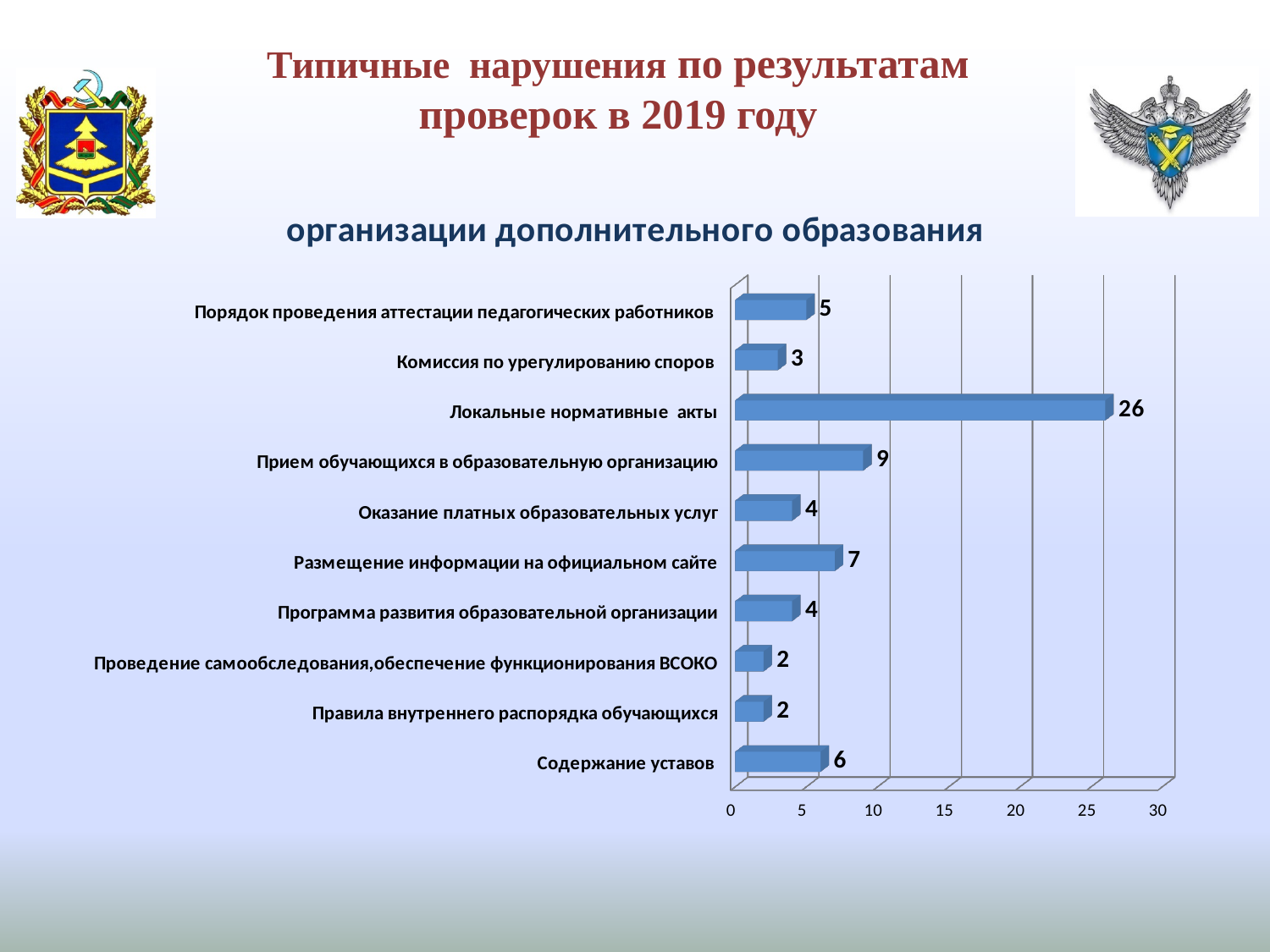
What is the value for Локальные нормативные акты? 26 How many categories are shown in the chart? 10 What is the value for Комиссия по урегулированию споров? 3 Which is larger: the value for Размещение информации на официальном сайте or the value for Порядок проведения аттестации педагогических работников? Размещение информации на официальном сайте Which category has the highest value? Локальные нормативные акты What is the value for Прием обучающихся в образовательную организацию? 9 Is the value for Локальные нормативные акты greater or less than 25? greater What is the subtitle shown above the chart? организации дополнительного образования What is the value for Содержание уставов? 6 What is the difference between the values for Содержание уставов and Оказание платных образовательных услуг? 2 What is the difference between the values for Локальные нормативные акты and Прием обучающихся в образовательную организацию? 17 What kind of chart is shown on the slide? bar chart